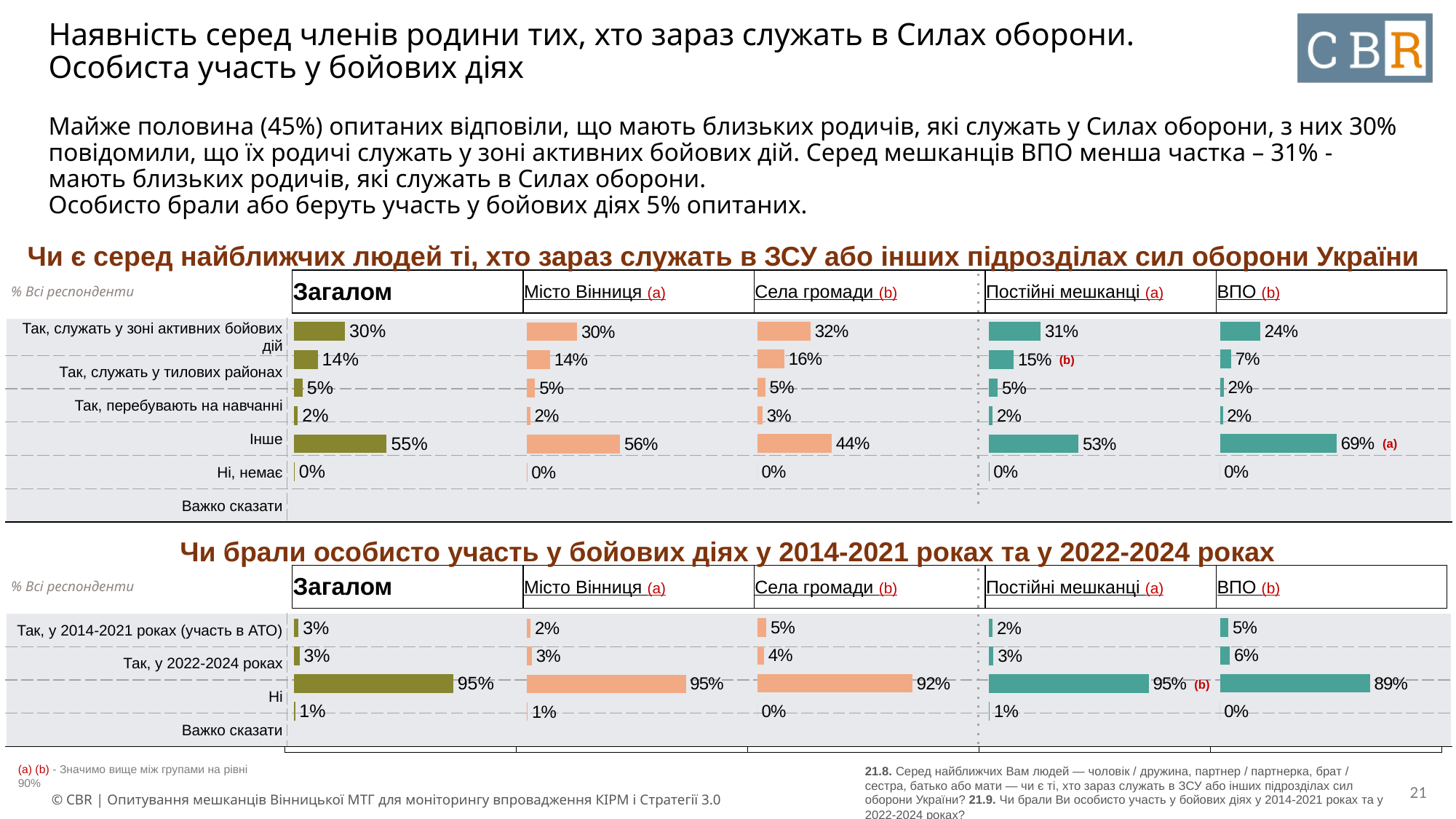
In the top chart, what is the value for 'Ні, немає' in the 'ВПО' column? 69% What type of chart is used on this slide? Bar chart In the top chart, what is the difference between 'Ні, немає' for 'ВПО' and for 'Постійні мешканці'? 16 percentage points In the top chart, which is larger for 'Так, служать у тилових районах': 'Постійні мешканці' or 'ВПО'? Постійні мешканці In the bottom chart, what is the value for 'Так, у 2022-2024 роках' in the 'ВПО' column? 6% In the top chart, which column has the lowest value for 'Так, служать у зоні активних бойових дій'? ВПО In the bottom chart, what is the difference between 'Ні' for 'Загалом' and for 'ВПО'? 6 percentage points In the bottom chart (personal participation in combat), what is the value for 'Ні' in the 'Села громади' column? 92% In the top chart, what is the value for 'Так, служать у тилових районах' in the 'Села громади' column? 16% In the top chart (service in the Defence Forces), what is the value for 'Так, служать у зоні активних бойових дій' in the 'Загалом' column? 30% In the bottom chart, which column has the lowest value for 'Ні'? ВПО How many respondent groups (columns) are shown in the top chart? 5